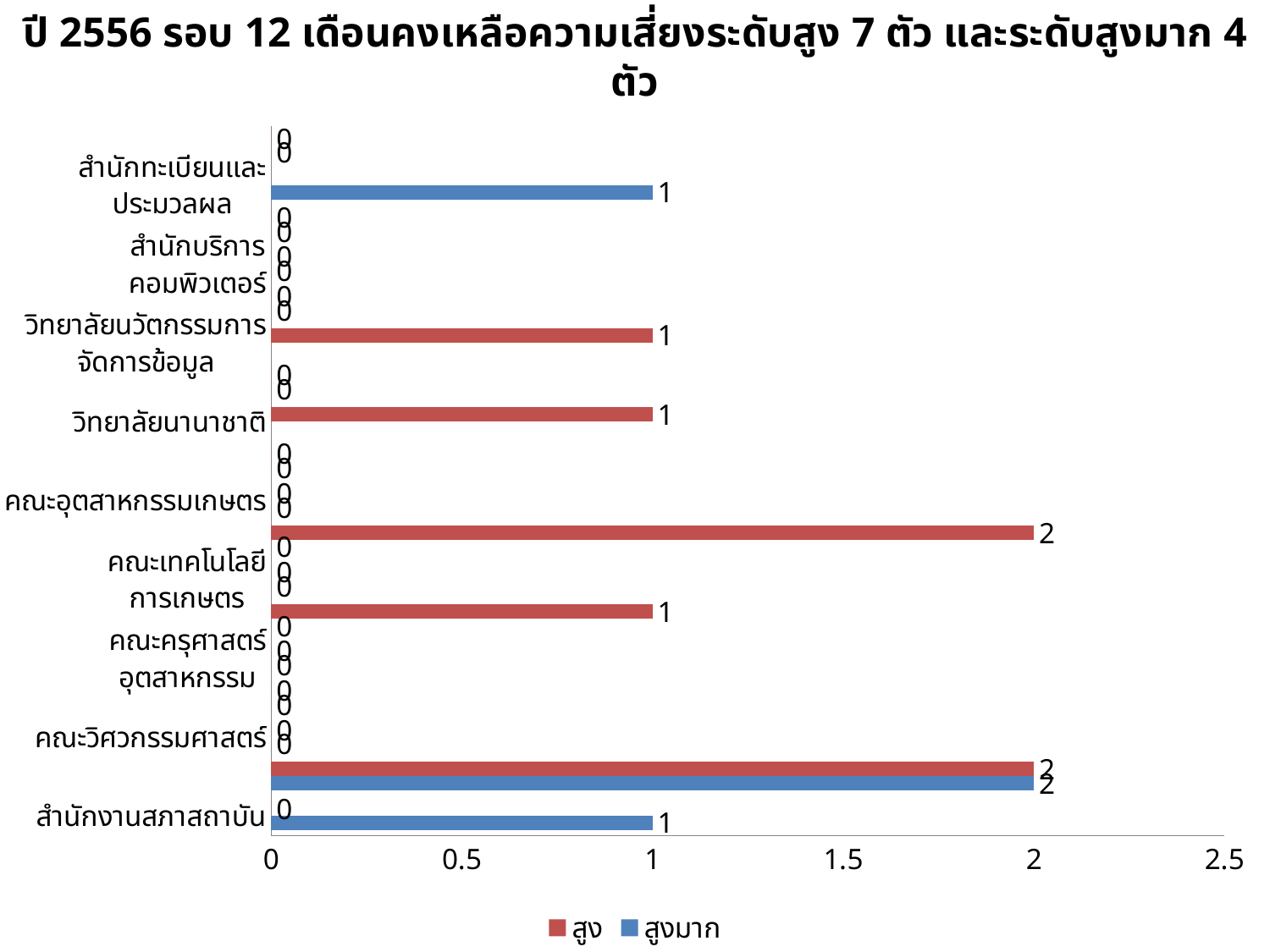
What is the largest value shown on the horizontal axis? 2.5 What is the value of สูง for สำนักงานสภาสถาบัน? 0 What is the highest value printed on any bar in the chart? 2 What is the difference between สูงมาก and สูง for สำนักงานสภาสถาบัน? 1 Which colour represents the สูง series? red For สำนักงานสภาสถาบัน, which is larger: สูง or สูงมาก? สูงมาก What is the value of สูงมาก for สำนักงานสภาสถาบัน? 1 What kind of chart is shown on the slide? bar chart Is the value of สูงมาก for สำนักงานสภาสถาบัน greater or less than 1.5? less What are the two series named in the legend? สูง and สูงมาก How many series does the legend list? 2